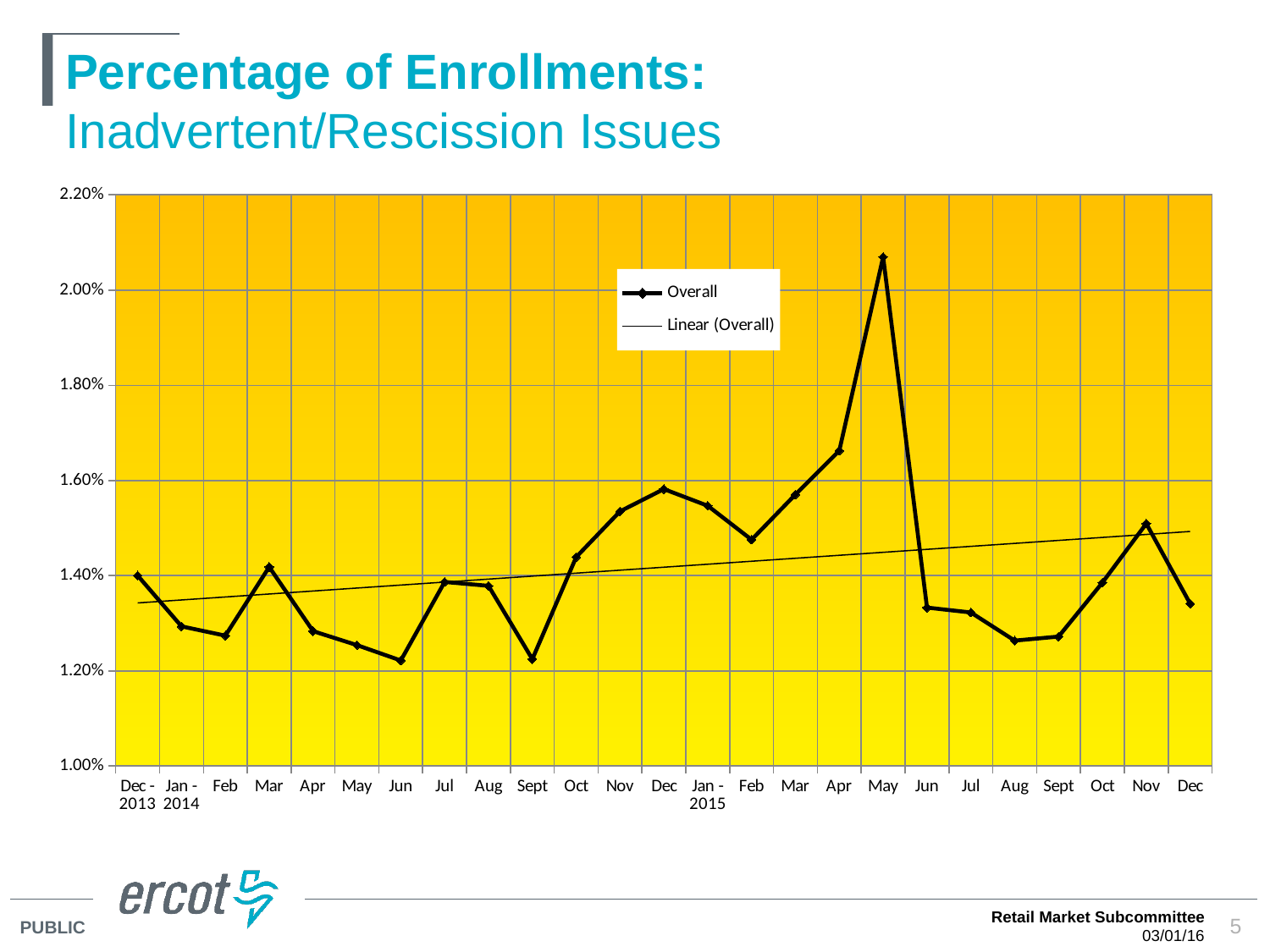
What are the two entries listed in the chart legend? Overall and Linear (Overall) How many series does the legend list? 2 Which month has the highest Overall value? May 2015 What kind of chart is shown on the slide? Line chart How many monthly data points are plotted on the Overall line? 25 Is the Overall value for Jun 2014 greater or less than 1.40%? less Which is larger, the Overall value for Feb 2014 or for Mar 2014? Mar 2014 Is the Overall value for Apr 2015 greater or less than 1.60%? greater Which is larger, the Overall value for Nov 2015 or for Dec 2015? Nov 2015 Does the Overall line rise or fall from Feb 2015 to May 2015? rise Is the Overall value for May 2015 greater or less than 2.00%? greater